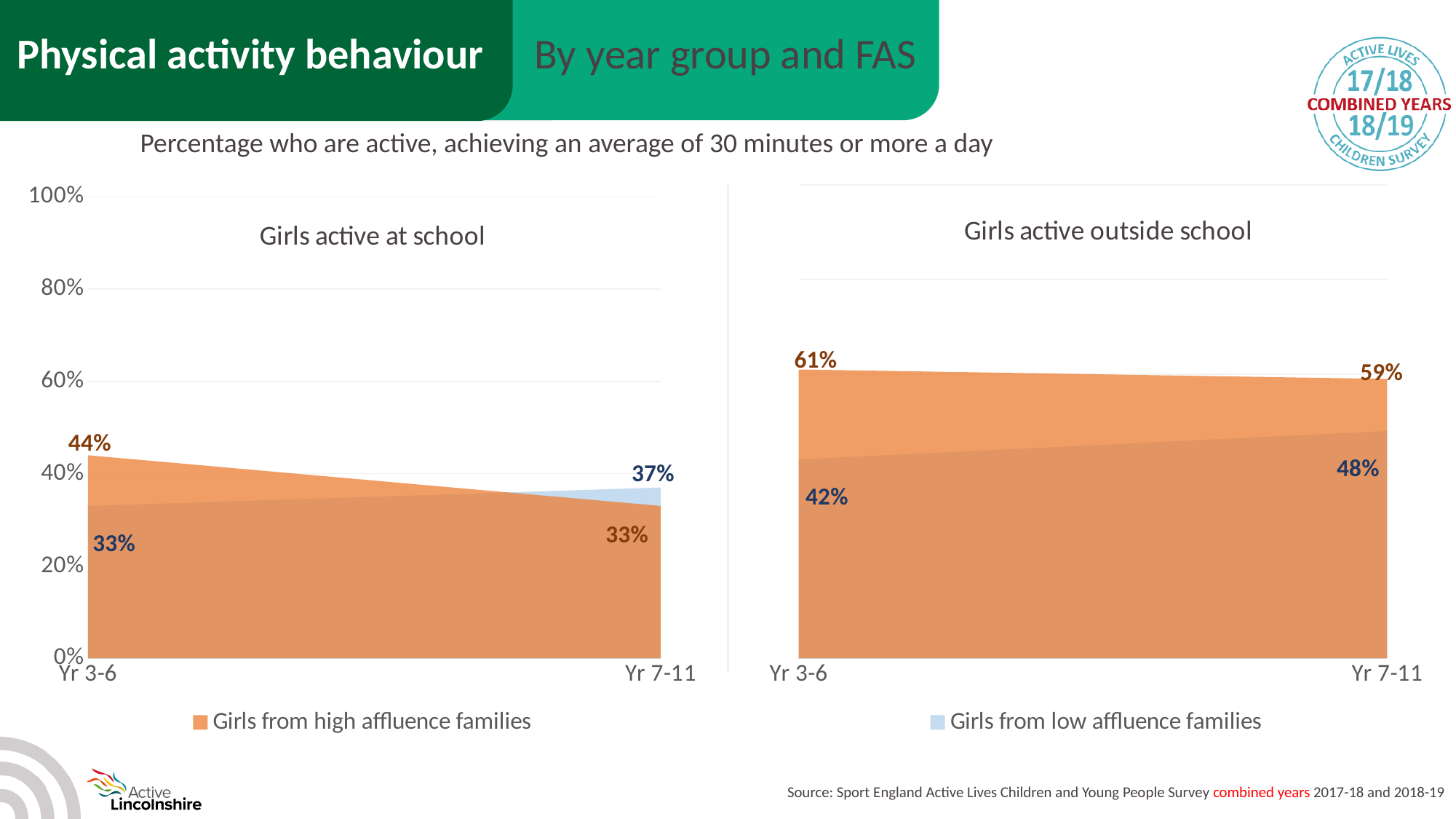
In the 'Girls active at school' chart, which series has the higher value in Yr 7-11, girls from high affluence families or girls from low affluence families? Girls from low affluence families In the 'Girls active at school' chart, what is the value for girls from high affluence families in Yr 3-6? 44% What kind of chart is used on this slide? Area chart In the 'Girls active outside school' chart, what is the value for girls from low affluence families in Yr 7-11? 48% In the 'Girls active at school' chart, what is the difference between the Yr 3-6 and Yr 7-11 values for girls from high affluence families? 11 percentage points In the 'Girls active outside school' chart, what is the value for girls from high affluence families in Yr 3-6? 61% In the 'Girls active at school' chart, does the value for girls from high affluence families rise or fall from Yr 3-6 to Yr 7-11? Fall How many series does the legend list? 2 In the 'Girls active outside school' chart, what is the difference between girls from high affluence families and girls from low affluence families in Yr 3-6? 19 percentage points In the 'Girls active outside school' chart, does the value for girls from low affluence families rise or fall from Yr 3-6 to Yr 7-11? Rise How many year groups are shown on the x axis of the 'Girls active outside school' chart? 2 In the 'Girls active at school' chart, what is the value for girls from low affluence families in Yr 7-11? 37%